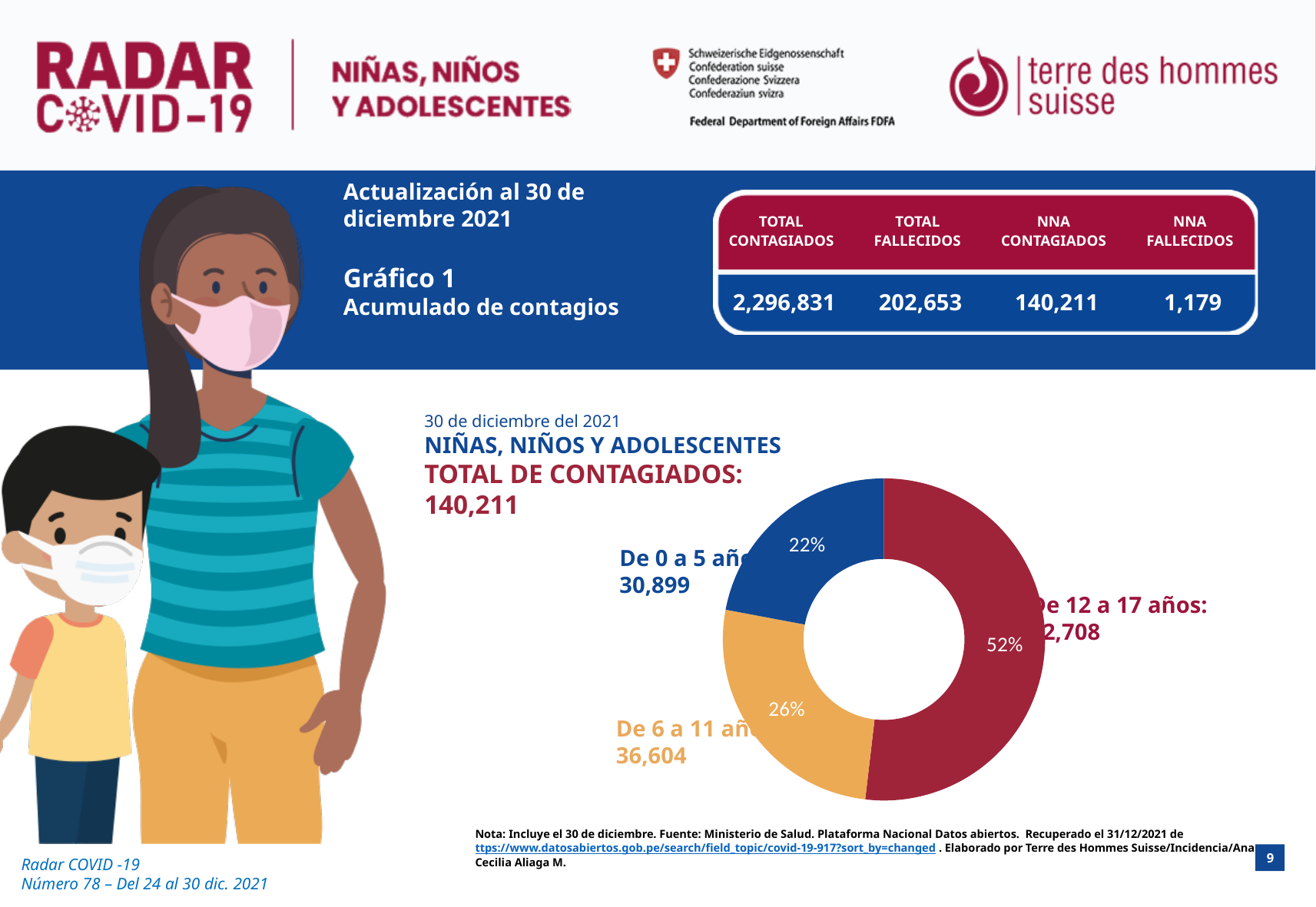
What total de contagiados is stated next to the pie chart? 140,211 What is the number of contagiados for 'De 0 a 5 años'? 30,899 What is the number of contagiados for 'De 6 a 11 años'? 36,604 What share of the pie does the 'De 12 a 17 años' slice represent? 52% How many age groups are shown in the pie chart? 3 Which has more contagiados, 'De 6 a 11 años' or 'De 0 a 5 años'? De 6 a 11 años Which age group has the largest slice of the pie? De 12 a 17 años What share of the pie does the 'De 0 a 5 años' slice represent? 22% Which age group has the smallest slice of the pie? De 0 a 5 años What share of the pie does the 'De 6 a 11 años' slice represent? 26% What kind of chart is shown on the slide? doughnut chart What is the difference in contagiados between 'De 6 a 11 años' and 'De 0 a 5 años'? 5,705